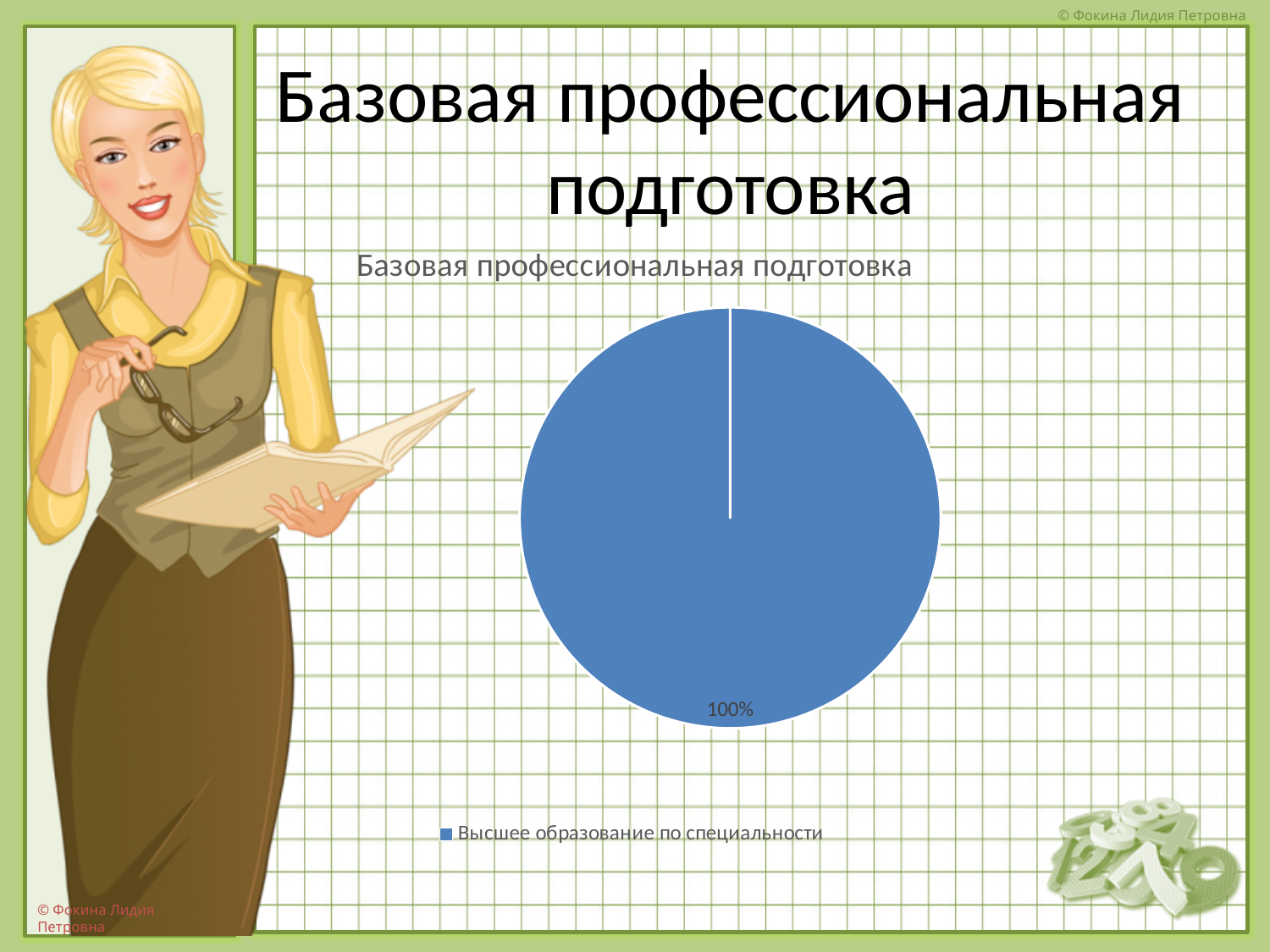
What kind of chart is shown on the slide? pie chart How many entries does the legend list? 1 What is the legend entry for the pie chart? Высшее образование по специальности What share of the pie does the slice 'Высшее образование по специальности' take? 100% Is the value for 'Высшее образование по специальности' greater or less than 50%? greater What value is printed on the pie slice? 100% What is the title of the chart? Базовая профессиональная подготовка How many slices does the pie chart have? 1